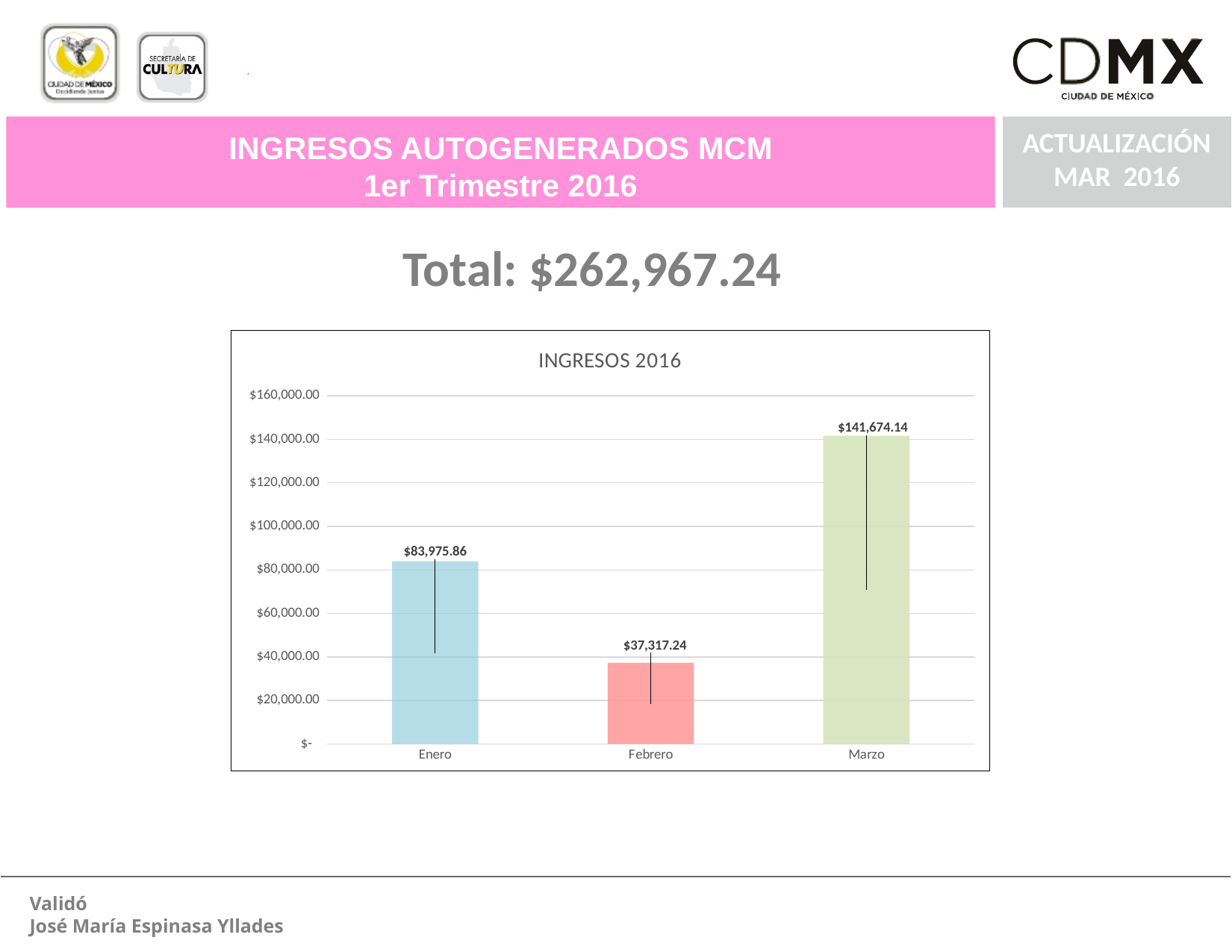
How many months are shown in the INGRESOS 2016 chart? 3 What kind of chart is the INGRESOS 2016 chart? Bar chart What is the title of the chart on the slide? INGRESOS 2016 What is the difference between the values for Marzo and Enero in the INGRESOS 2016 chart? $57,698.28 Which is larger in the INGRESOS 2016 chart, the value for Enero or the value for Febrero? Enero What is the difference between the values for Enero and Febrero in the INGRESOS 2016 chart? $46,658.62 Which month has the lowest value in the INGRESOS 2016 chart? Febrero What is the value for Marzo in the INGRESOS 2016 chart? $141,674.14 What is the value for Febrero in the INGRESOS 2016 chart? $37,317.24 Is the value for Marzo in the INGRESOS 2016 chart greater or less than $120,000.00? greater Which month has the highest value in the INGRESOS 2016 chart? Marzo What is the value for Enero in the INGRESOS 2016 chart? $83,975.86